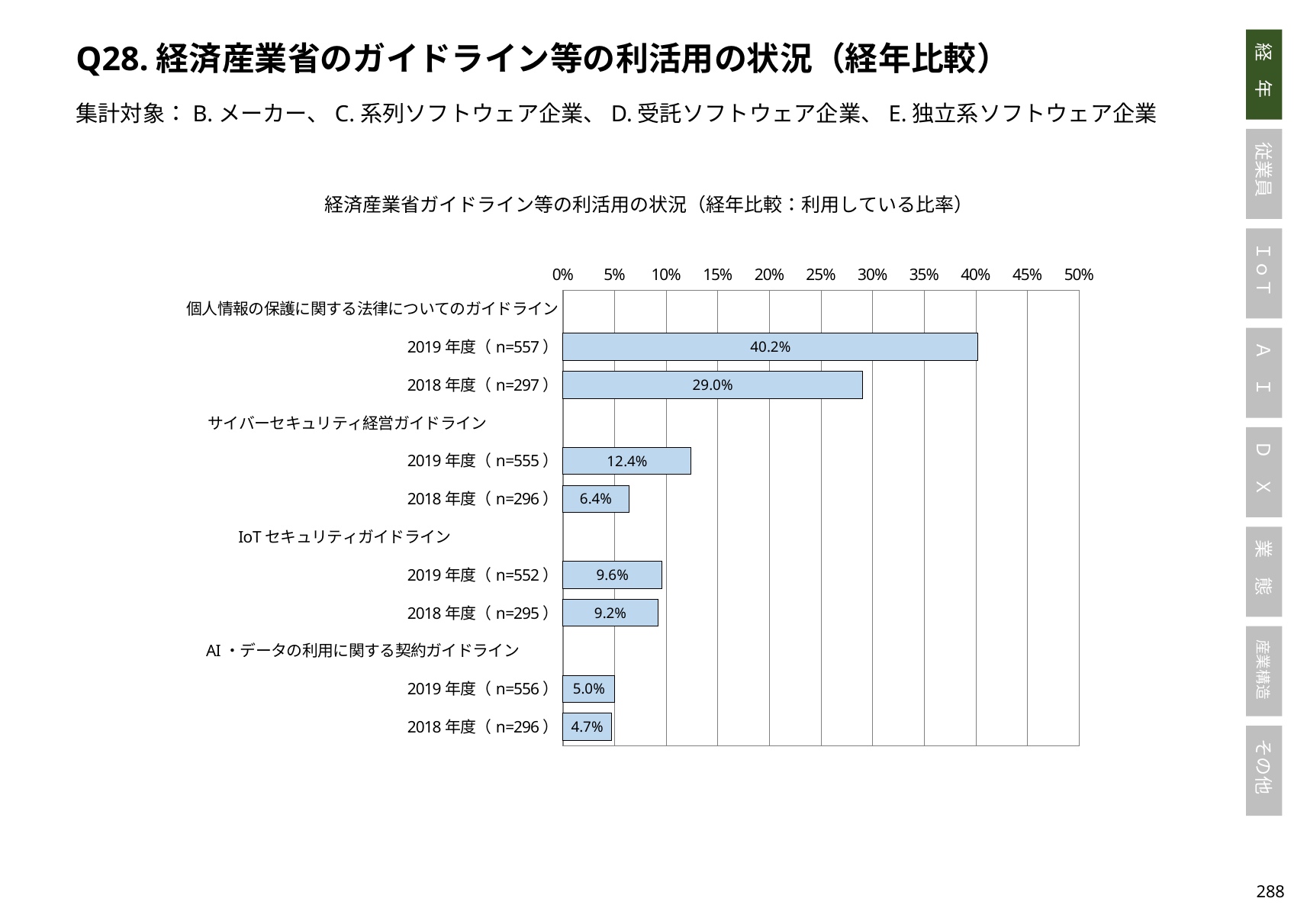
Which is larger: the 2019年度 value for IoTセキュリティガイドライン or the 2019年度 value for サイバーセキュリティ経営ガイドライン? サイバーセキュリティ経営ガイドライン 2019年度 How many bars are plotted in the chart? 8 What is the value for サイバーセキュリティ経営ガイドライン in 2018年度 (n=296)? 6.4% What is the value for 個人情報の保護に関する法律についてのガイドライン in 2019年度 (n=557)? 40.2% What is the maximum value shown on the percentage axis of the chart? 50% What kind of chart is shown on the slide? Bar chart Which bar has the lowest value in the chart? AI・データの利用に関する契約ガイドライン 2018年度 (n=296) What is the value for AI・データの利用に関する契約ガイドライン in 2018年度 (n=296)? 4.7% What is the difference between the 2019年度 and 2018年度 values for サイバーセキュリティ経営ガイドライン? 6.0% Which bar has the highest value in the chart? 個人情報の保護に関する法律についてのガイドライン 2019年度 (n=557) What is the value for IoTセキュリティガイドライン in 2019年度 (n=552)? 9.6% What is the difference between the 2019年度 and 2018年度 values for 個人情報の保護に関する法律についてのガイドライン? 11.2%